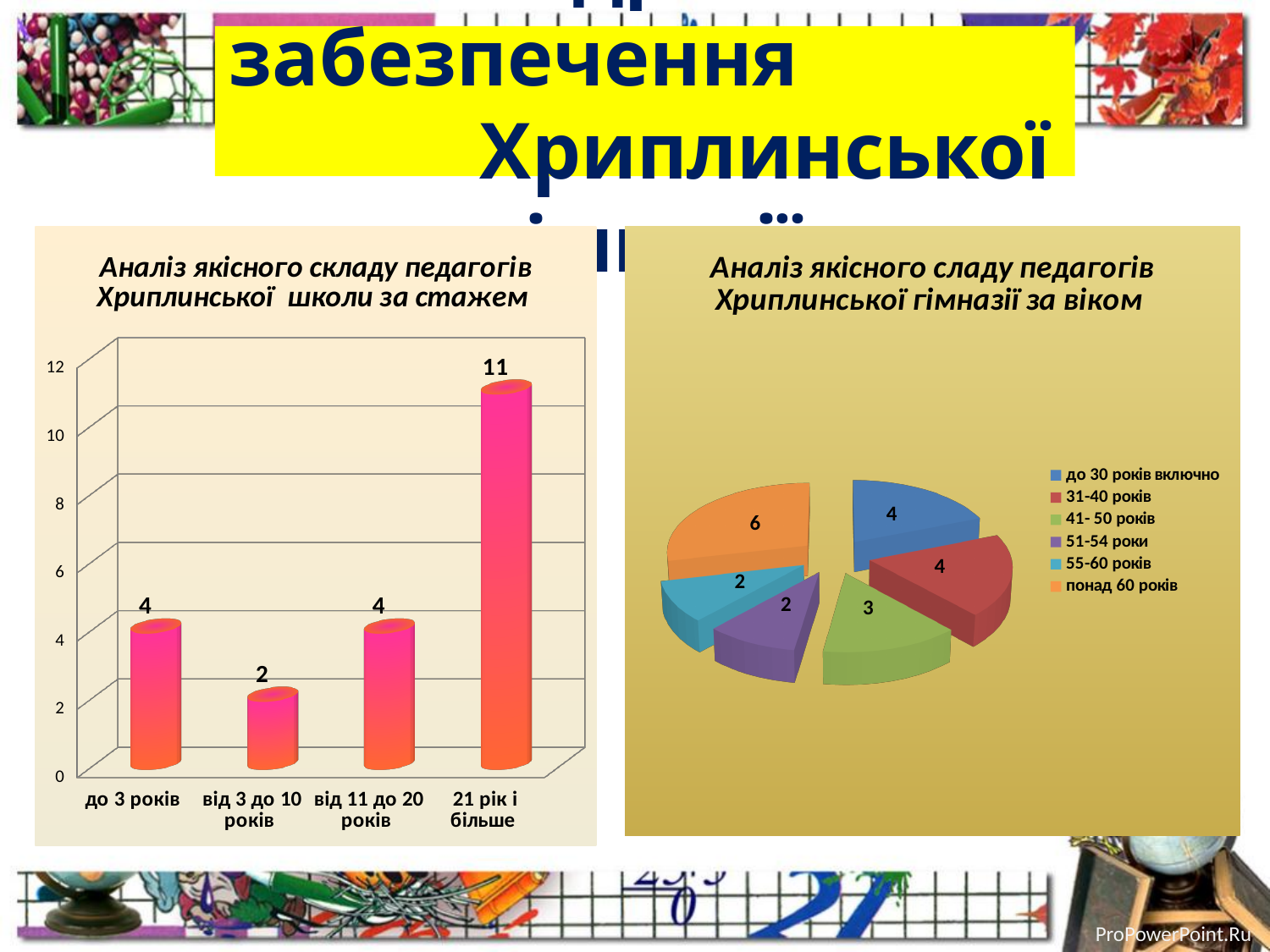
In the bar chart on the left, what is the difference between the values for '21 рік і більше' and 'до 3 років'? 7 In the bar chart on the left, which category has the highest value? 21 рік і більше In the bar chart on the left, what is the value for 'від 3 до 10 років'? 2 In the bar chart on the left, how many categories are shown on the x axis? 4 In the bar chart on the left, which category has the lowest value? від 3 до 10 років In the pie chart on the right, what is the value for '41- 50 років'? 3 In the pie chart on the right, which category has the largest slice? понад 60 років In the bar chart on the left, what is the value for '21 рік і більше'? 11 What kind of chart is the chart on the left? bar chart What kind of chart is the chart on the right? pie chart In the pie chart on the right, what is the value for 'понад 60 років'? 6 In the pie chart on the right, how many series does the legend list? 6